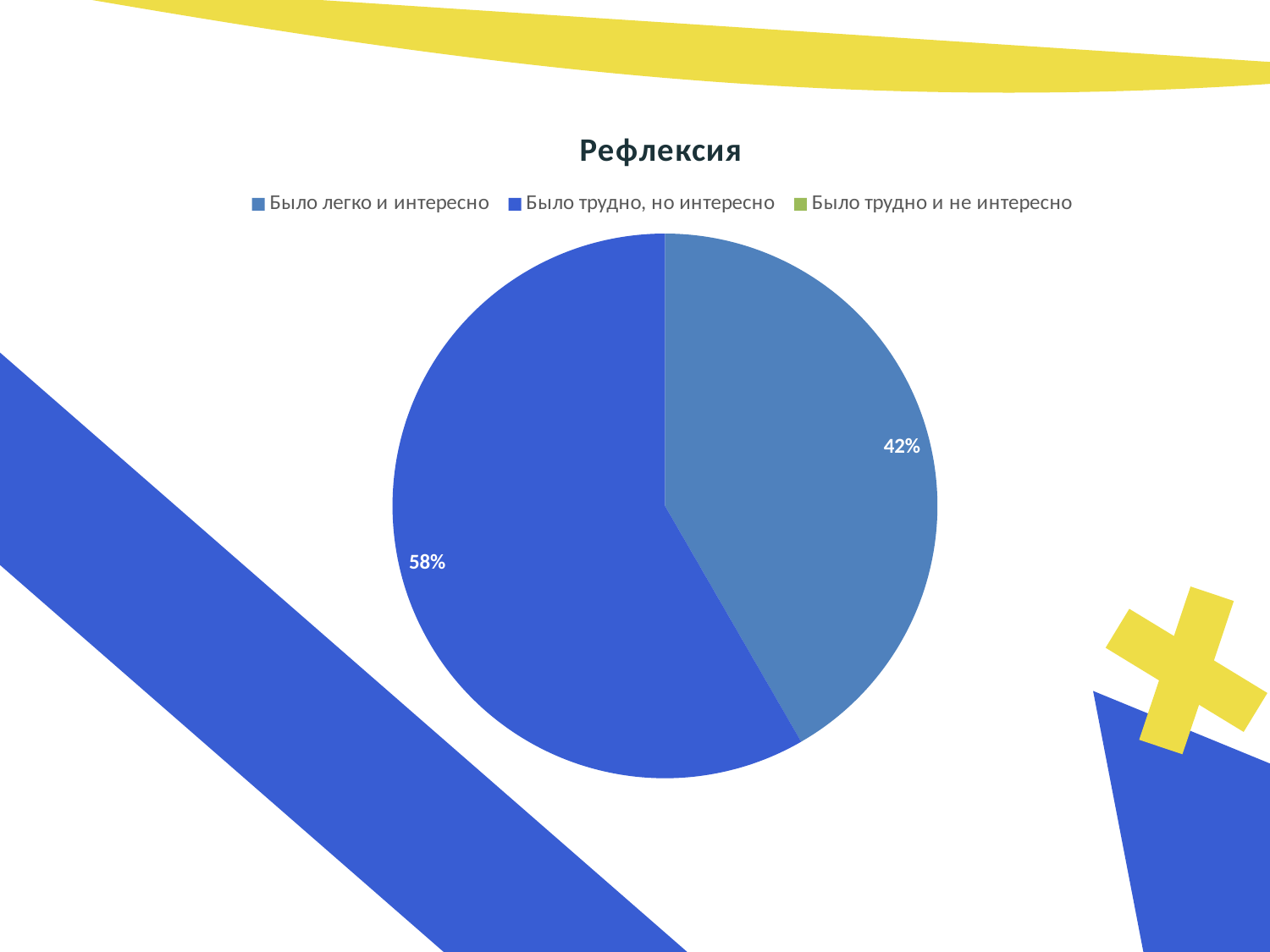
Which legend entry has no visible slice in the pie? Было трудно и не интересно Which category has the largest slice of the pie? Было трудно, но интересно What kind of chart is shown on the slide? pie chart How many entries does the legend list? 3 Which is larger: the slice for "Было легко и интересно" or the slice for "Было трудно, но интересно"? Было трудно, но интересно How many slices with data labels are visible in the pie? 2 By how many percentage points does "Было трудно, но интересно" exceed "Было легко и интересно"? 16 percentage points What is the title of the chart? Рефлексия Is the share for "Было легко и интересно" greater or less than 50%? less What share of the pie does "Было легко и интересно" take? 42% What share of the pie does "Было трудно, но интересно" take? 58%